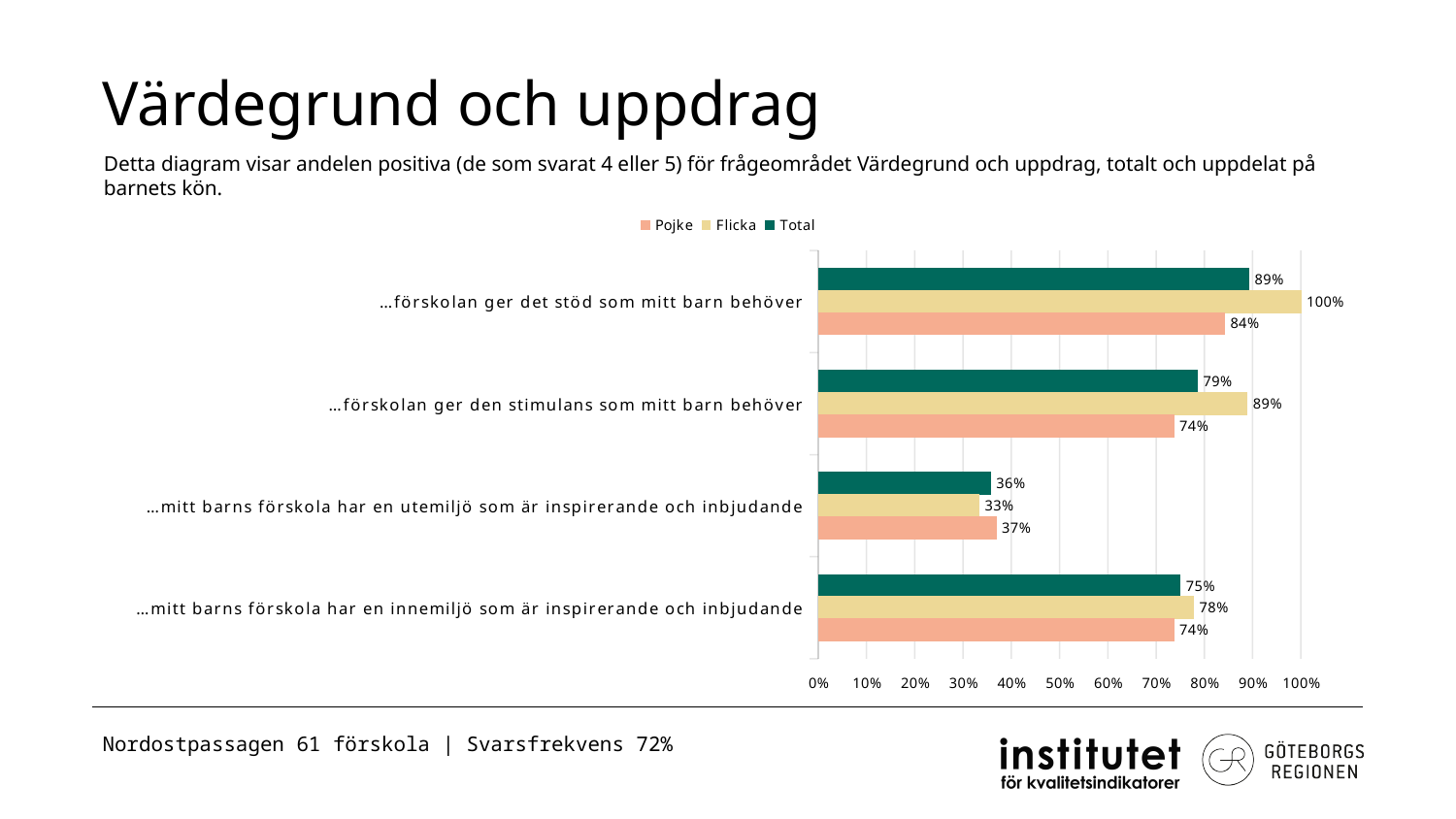
How many series does the legend list? 3 Is the Total value for "…mitt barns förskola har en utemiljö som är inspirerande och inbjudande" greater or less than 50%? less What is the Total value for "…förskolan ger det stöd som mitt barn behöver"? 89% For "…förskolan ger den stimulans som mitt barn behöver", which is larger, the Flicka value or the Pojke value? Flicka Which category has the lowest Flicka value? …mitt barns förskola har en utemiljö som är inspirerande och inbjudande What is the difference between the Flicka and Pojke values for "…förskolan ger det stöd som mitt barn behöver"? 16% How many categories are shown on the chart? 4 What kind of chart is shown on the slide? Bar chart What is the Pojke value for "…mitt barns förskola har en utemiljö som är inspirerande och inbjudande"? 37% What is the Flicka value for "…förskolan ger den stimulans som mitt barn behöver"? 89% What is the Flicka value for "…mitt barns förskola har en innemiljö som är inspirerande och inbjudande"? 78% Which category has the highest Total value? …förskolan ger det stöd som mitt barn behöver